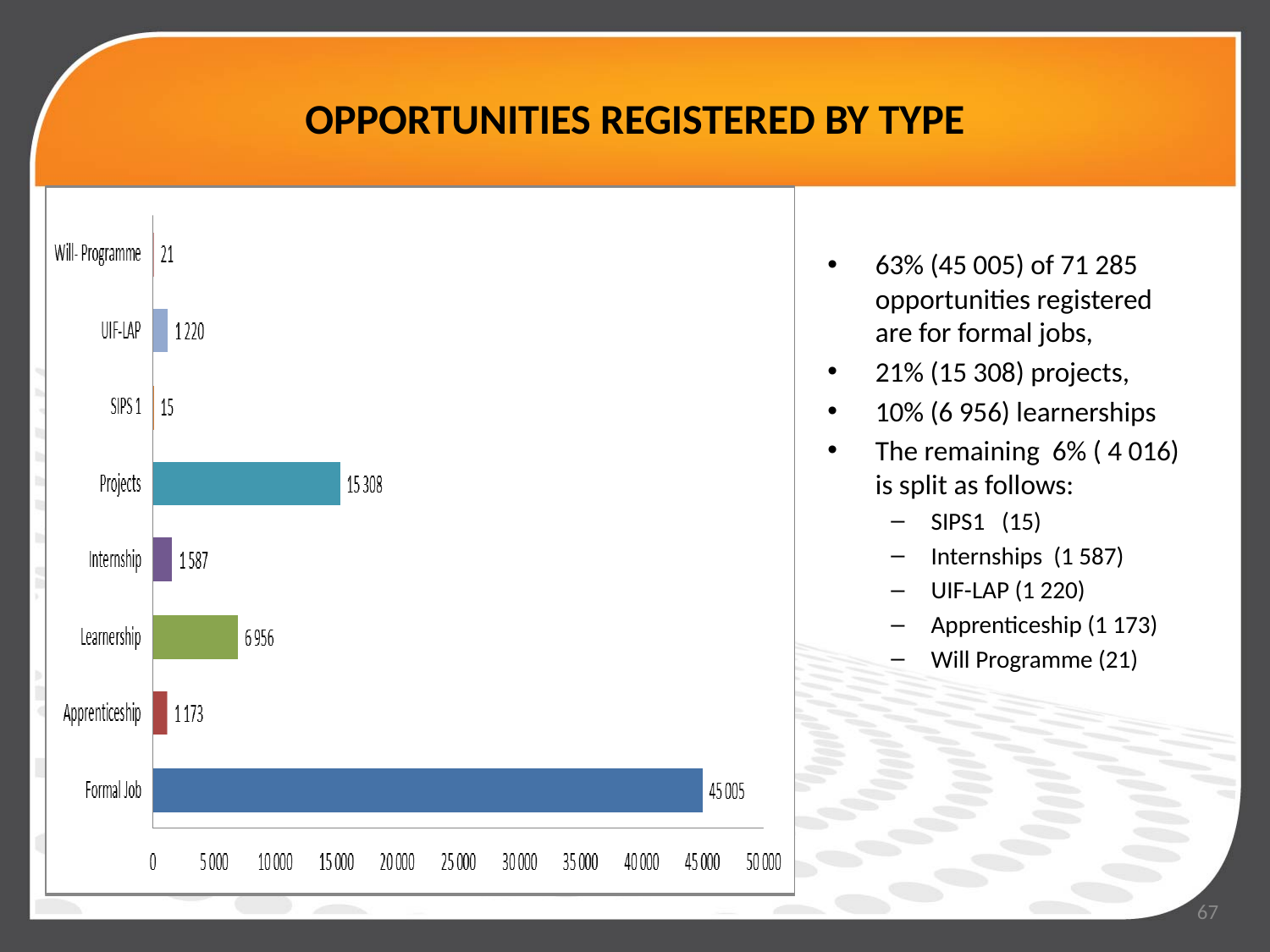
What kind of chart is shown on the slide? bar chart What is the value for Will- Programme? 21 What is the value for Formal Job? 45 005 Which is larger, the value for Internship or the value for Apprenticeship? Internship What is the difference between the values for Projects and Learnership? 8 352 What is the value for UIF-LAP? 1 220 Which category has the highest value? Formal Job What is the value for Learnership? 6 956 How many categories are shown in the chart? 8 Which category has the lowest value? SIPS 1 What is the difference between the values for Formal Job and Projects? 29 697 Is the value for Projects greater or less than 10 000? greater